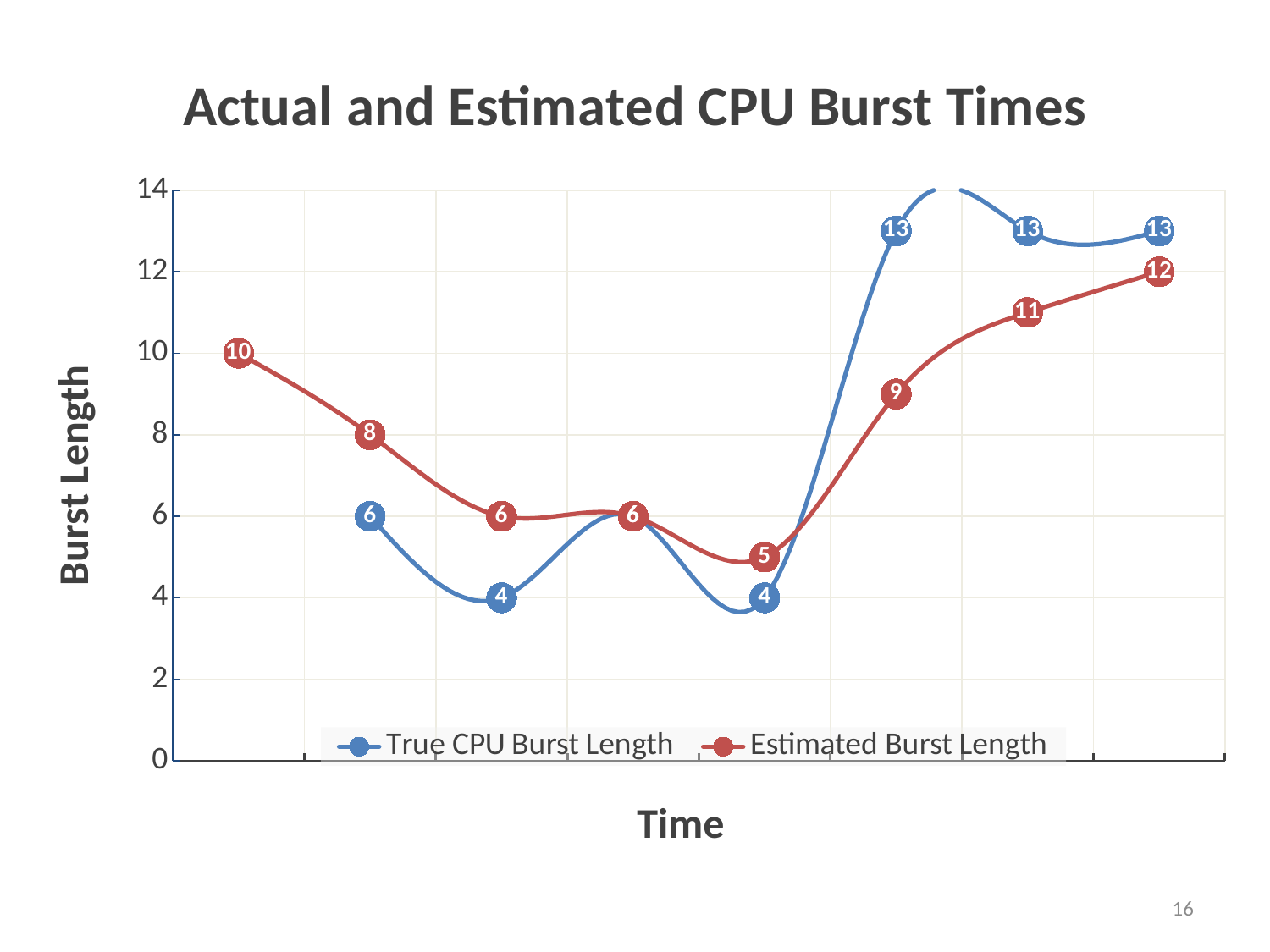
What is the last plotted value of the Estimated Burst Length series? 12 How many series does the legend list? 2 What is the last plotted value of the True CPU Burst Length series? 13 What is the title of the chart? Actual and Estimated CPU Burst Times What is the first plotted value of the Estimated Burst Length series? 10 What type of chart is shown on the slide? line chart How many data points are plotted for the True CPU Burst Length series? 7 What is the lowest value plotted for the Estimated Burst Length series? 5 What is the lowest value plotted for the True CPU Burst Length series? 4 Which series has the higher final value, True CPU Burst Length or Estimated Burst Length? True CPU Burst Length How many data points are plotted for the Estimated Burst Length series? 8 What is the difference between the last True CPU Burst Length value and the last Estimated Burst Length value? 1